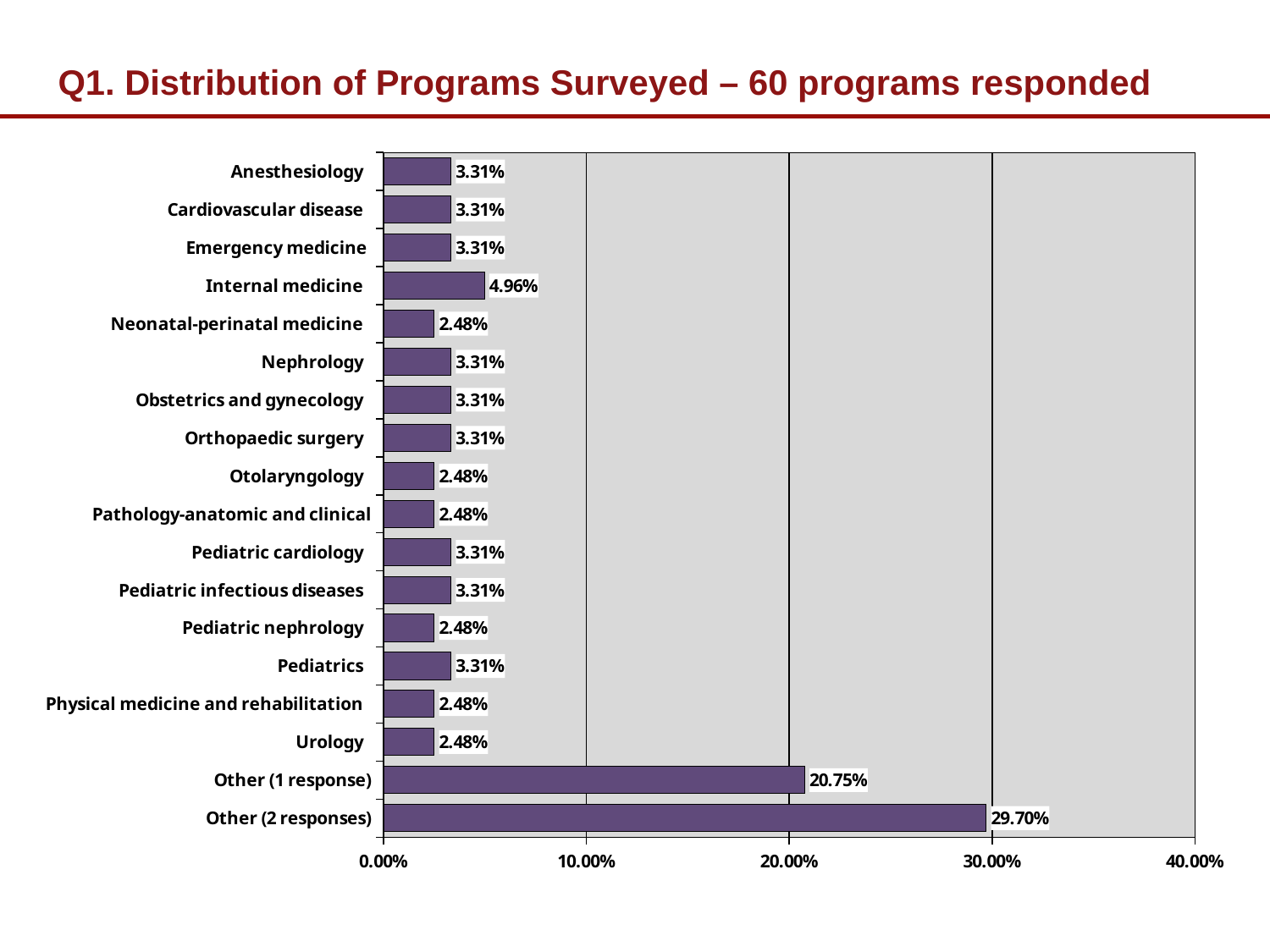
Is the value for Other (1 response) greater or less than 30.00%? less What is the value for Other (1 response)? 20.75% What is the value for Other (2 responses)? 29.70% What is the value for Urology? 2.48% Which category has the highest value? Other (2 responses) What is the title of the slide? Q1. Distribution of Programs Surveyed – 60 programs responded What is the difference between Other (2 responses) and Other (1 response)? 8.95% What is the value for Internal medicine? 4.96% Which is larger, Internal medicine or Anesthesiology? Internal medicine How many categories are shown in the chart? 18 What kind of chart is shown on the slide? Bar chart What is the difference between Internal medicine and Neonatal-perinatal medicine? 2.48%